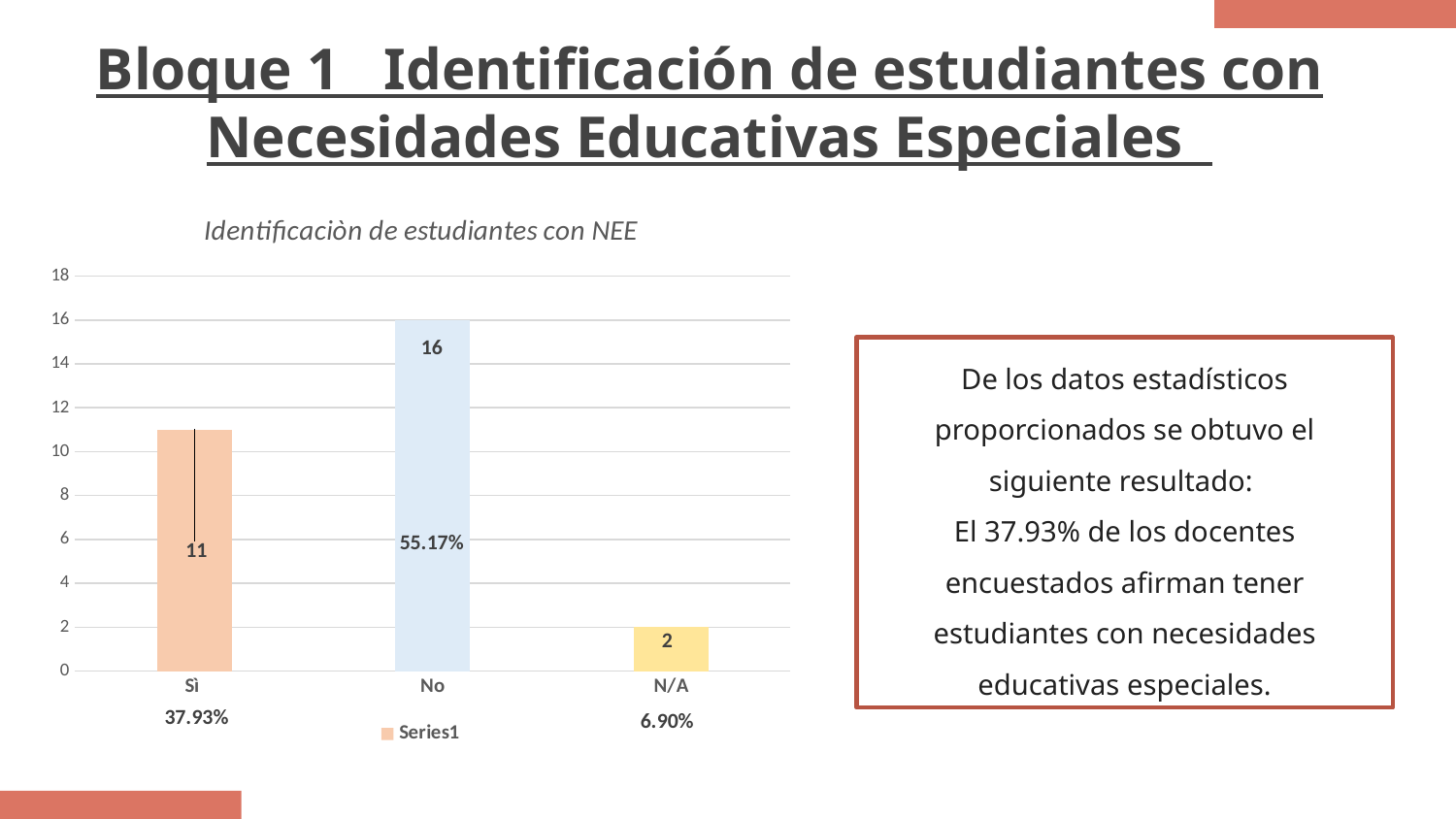
What is the value for the "No" category? 16 What is the title of the chart? Identificaciòn de estudiantes con NEE What is the difference between the values for "No" and "Sì"? 5 Which category has the lowest value? N/A What kind of chart is shown? Bar chart What is the value for the "N/A" category? 2 What percentage is shown under the "No" category? 55.17% How many series does the legend list? 1 Which category has the highest value? No Which is larger, the value for "Sì" or the value for "N/A"? Sì How many categories are shown on the x axis? 3 What is the value for the "Sì" category? 11